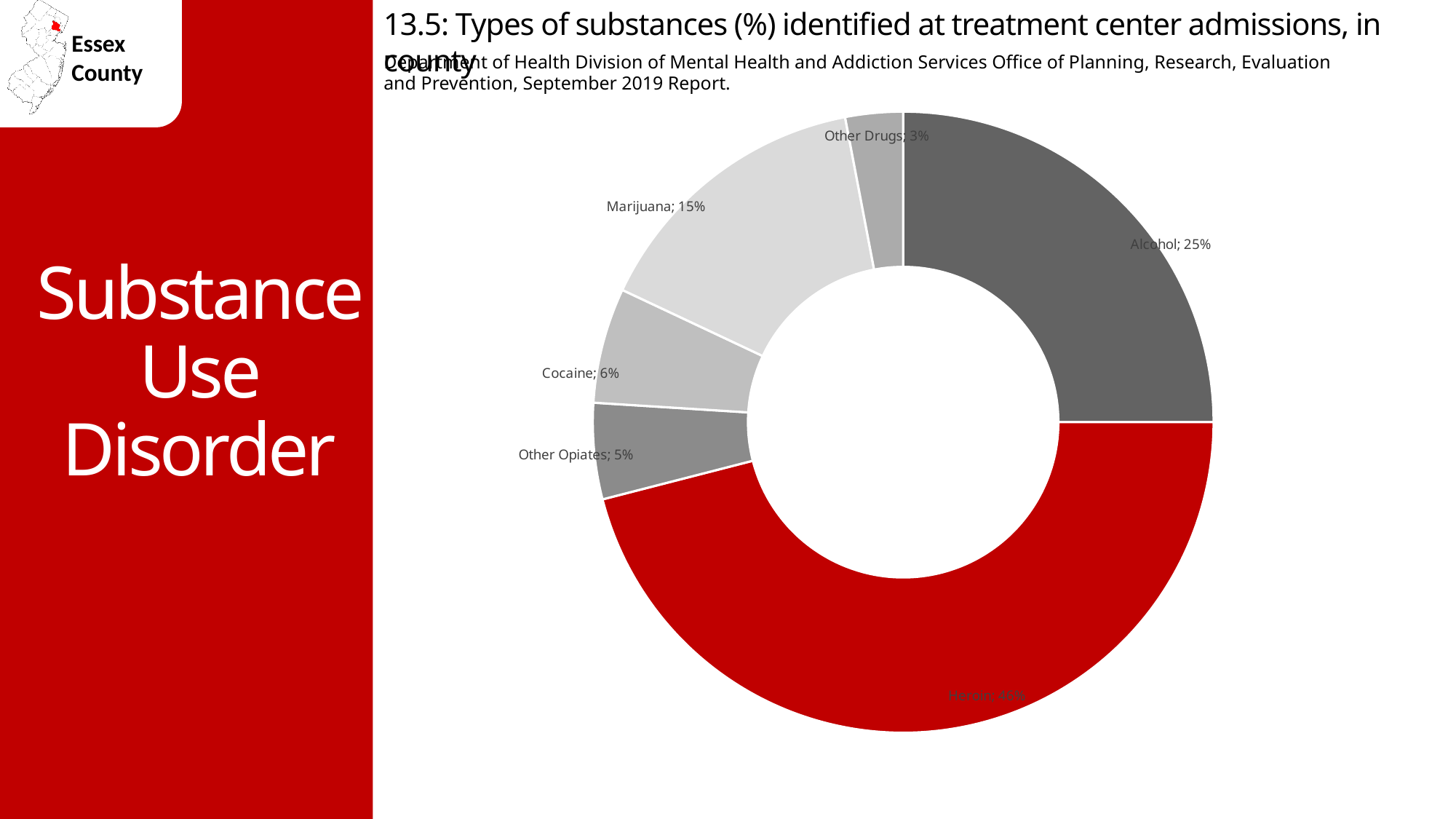
Which has a larger share of admissions, Cocaine or Other Opiates? Cocaine What percentage of treatment center admissions is attributed to Alcohol? 25% Which substance accounts for the smallest share of treatment center admissions? Other Drugs What percentage of treatment center admissions is attributed to Other Opiates? 5% What percentage of treatment center admissions is attributed to Other Drugs? 3% What is the difference in percentage points between Alcohol and Marijuana? 10 Which substance accounts for the largest share of treatment center admissions? Heroin What percentage of treatment center admissions is attributed to Cocaine? 6% How many substance categories are shown in the chart? 6 What percentage of treatment center admissions is attributed to Marijuana? 15% What type of chart is used on this slide? Pie chart (doughnut) Which slice of the chart is colored red? Heroin